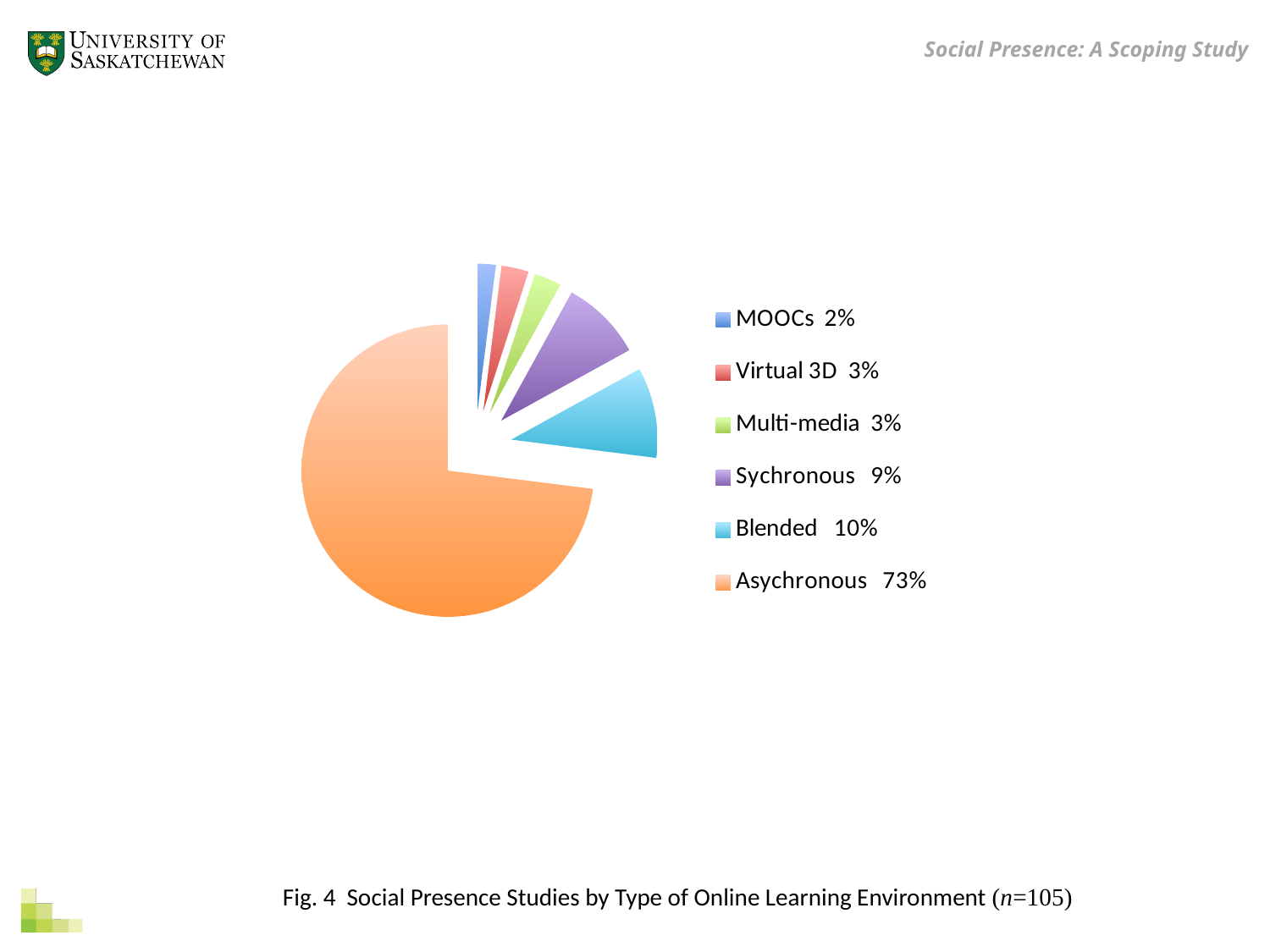
What percentage is shown for Sychronous? 9% What percentage is shown for MOOCs? 2% How many categories does the pie chart show? 6 Which category has the largest slice of the pie? Asychronous Which category has the smallest slice of the pie? MOOCs What is the difference in percentage points between Blended and Sychronous? 1% What share of the pie does Asychronous represent? 73% What is the difference in percentage points between Asychronous and Blended? 63% What kind of chart is shown on the slide? pie chart What percentage is shown for Blended? 10% Which is larger, the share for Blended or the share for Virtual 3D? Blended What is the caption of the figure shown on the slide? Fig. 4 Social Presence Studies by Type of Online Learning Environment (n=105)